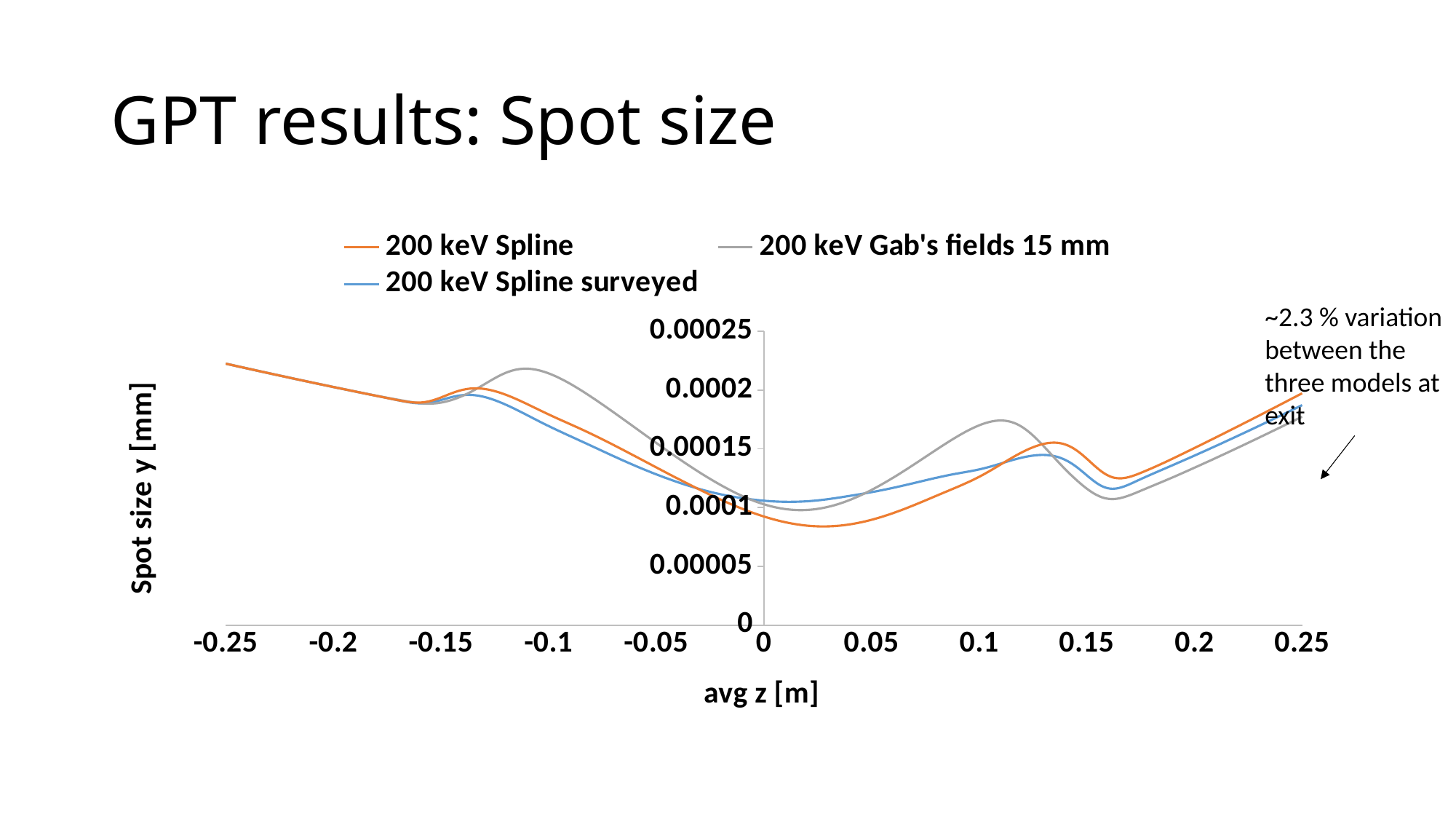
Is the value of the 200 keV Spline series at avg z = 0.03 greater or less than 0.0001? less Is the value of the 200 keV Spline series at avg z = -0.25 greater or less than 0.0002? greater How many series does the legend list? 3 What is the label of the y axis? Spot size y [mm] At avg z = 0.03, which series has the larger spot size, 200 keV Spline or 200 keV Spline surveyed? 200 keV Spline surveyed Is the value of the 200 keV Gab's fields 15 mm series at avg z = 0.1 greater or less than 0.00015? greater What is the label of the x axis? avg z [m] Do the spot size values rise or fall as avg z goes from -0.25 to -0.15? fall Which series reaches the highest spot size between avg z = -0.15 and avg z = -0.05? 200 keV Gab's fields 15 mm What kind of chart is shown on the slide? line chart Do the spot size values rise or fall as avg z goes from 0.15 to 0.25? rise